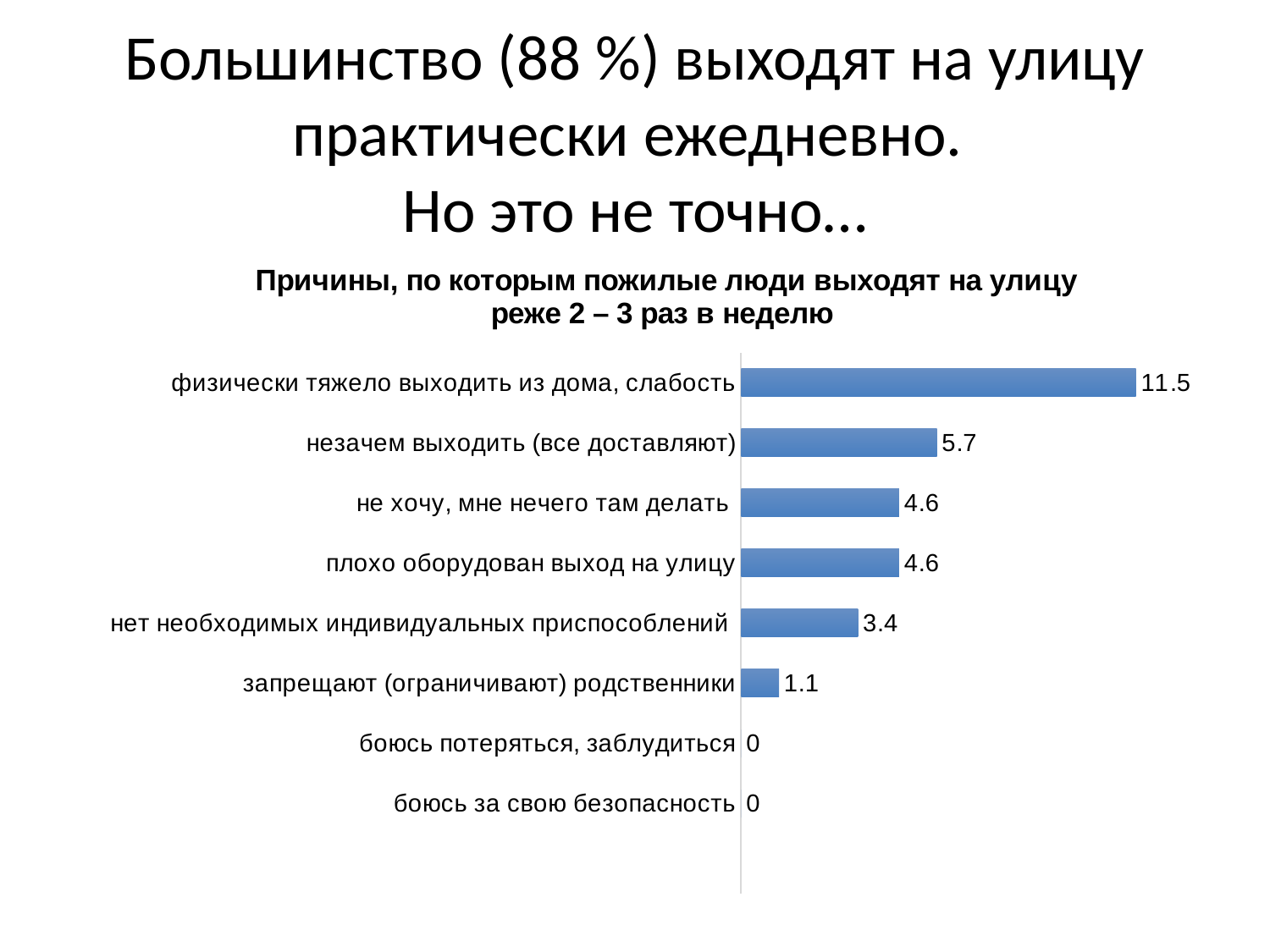
How many categories are shown in the chart? 8 What is the difference between the values for "физически тяжело выходить из дома, слабость" and "незачем выходить (все доставляют)"? 5.8 What is the value for "запрещают (ограничивают) родственники"? 1.1 What is the value for "физически тяжело выходить из дома, слабость"? 11.5 What kind of chart is shown on the slide? bar chart What is the value for "нет необходимых индивидуальных приспособлений"? 3.4 Which category has the highest value? физически тяжело выходить из дома, слабость What is the title of the chart? Причины, по которым пожилые люди выходят на улицу реже 2 – 3 раз в неделю What is the difference between the values for "не хочу, мне нечего там делать" and "нет необходимых индивидуальных приспособлений"? 1.2 How many categories have a value of 0? 2 Which is larger, the value for "незачем выходить (все доставляют)" or the value for "плохо оборудован выход на улицу"? незачем выходить (все доставляют) What is the value for "незачем выходить (все доставляют)"? 5.7